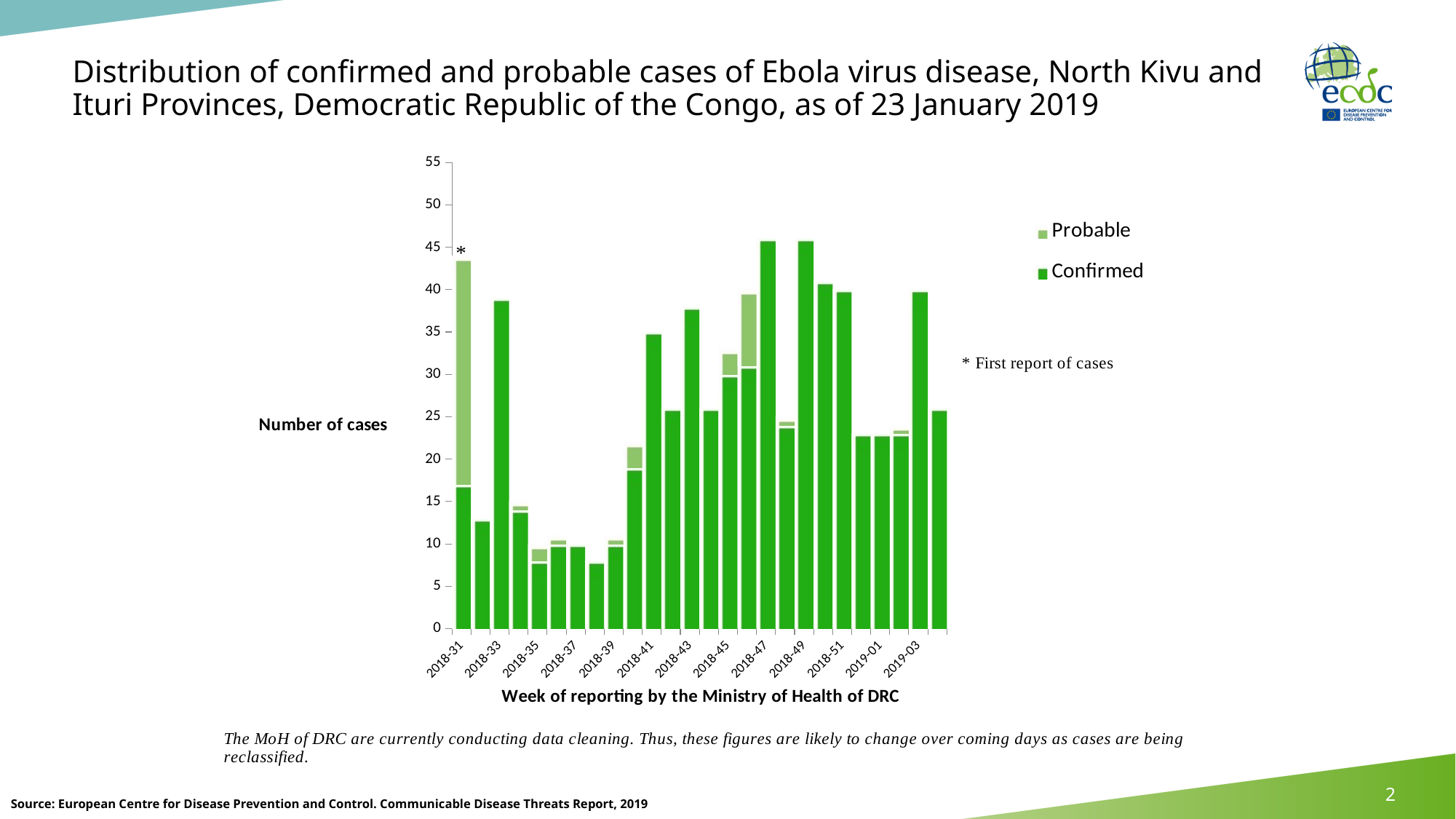
Is the number of cases for week 2018-39 greater or less than 15? less How many series does the legend list? 2 Is the total number of cases for week 2018-31 greater or less than 40? greater Is the number of cases for week 2019-03 greater or less than 45? less What is the title of the x axis? Week of reporting by the Ministry of Health of DRC Which week has more cases, 2018-33 or 2018-35? 2018-33 What are the two series named in the legend? Probable and Confirmed Which week has more cases, 2018-47 or 2018-45? 2018-47 What kind of chart is shown on the slide? Stacked bar chart